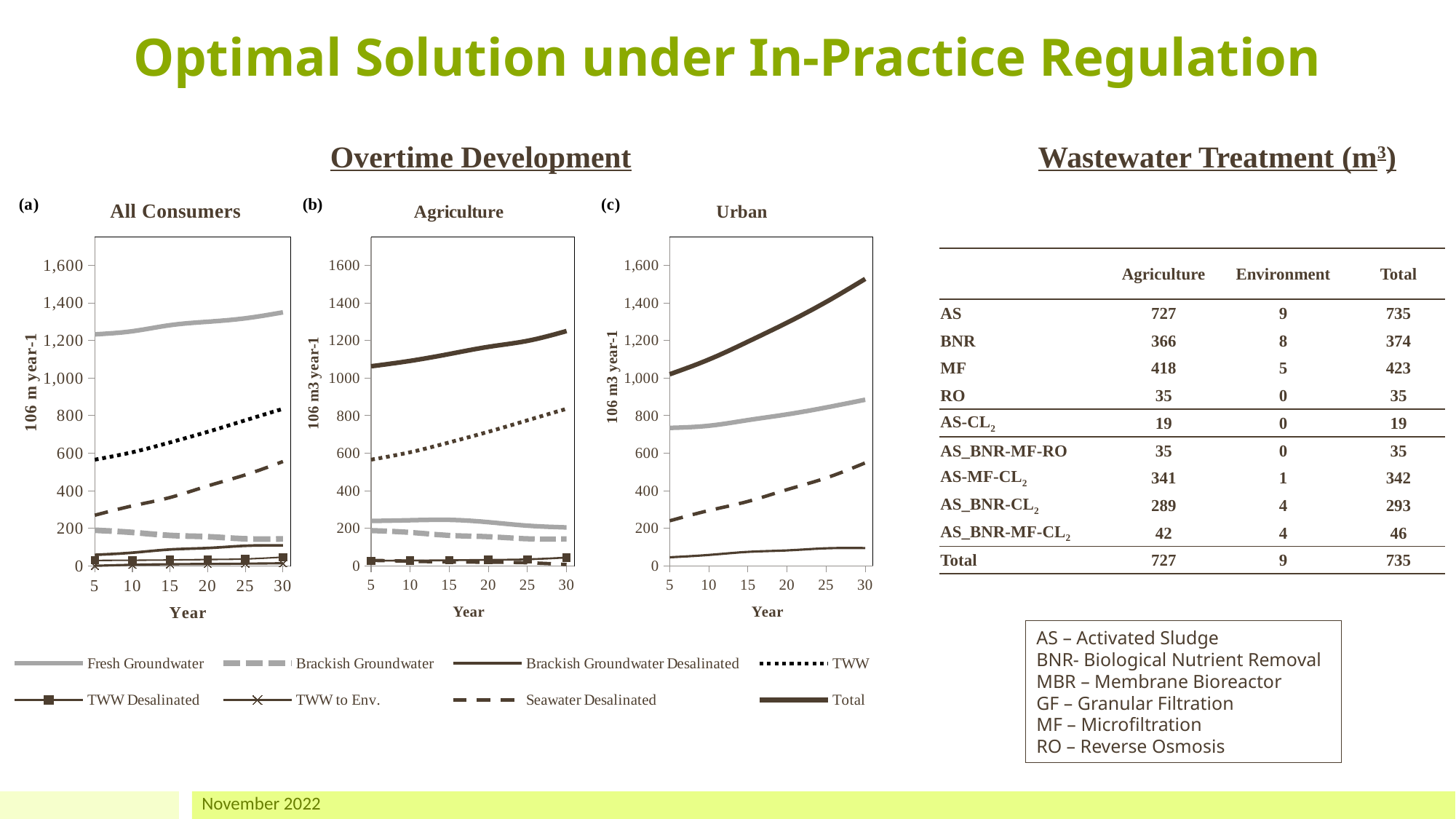
In the Urban chart (c), which series has the highest value at year 30? Total In the Urban chart (c), which is larger at year 30: Fresh Groundwater or Seawater Desalinated? Fresh Groundwater In the Agriculture chart (b), is the Total value at year 30 greater or less than 1000? greater In the All Consumers chart (a), does the Brackish Groundwater series rise or fall from year 5 to year 30? Fall In the Urban chart (c), does the Total series rise or fall from year 5 to year 30? Rise In the Urban chart (c), is the Total value at year 30 greater or less than 1,400? greater What is the x-axis title of the Agriculture chart (b)? Year How many series does the shared legend below the three charts list? 8 How many year points are marked on the x axis of the Urban chart (c)? 6 What kind of chart is the All Consumers chart (a)? Line chart In the All Consumers chart (a), is the TWW value at year 30 greater or less than 600? greater